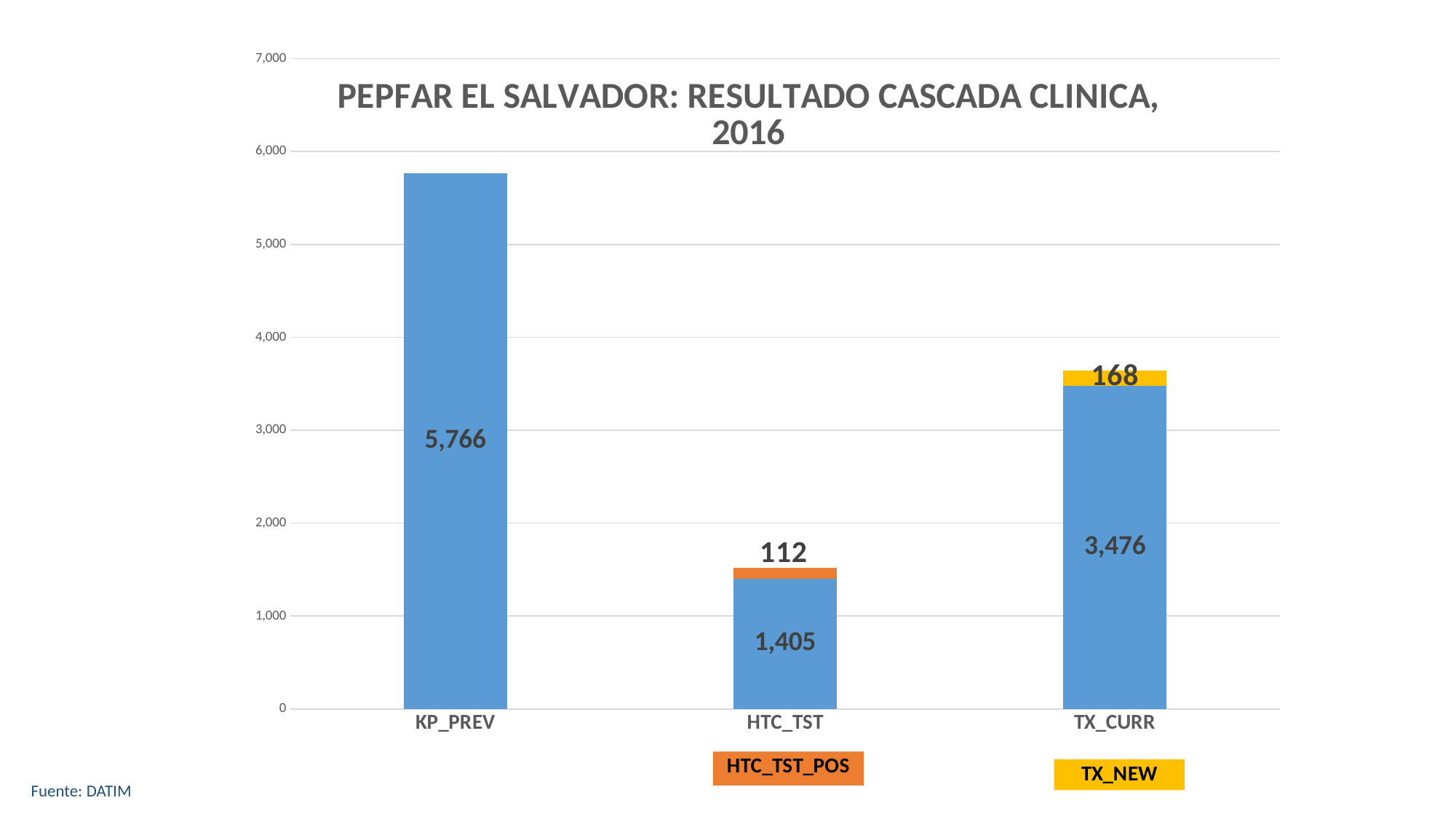
Which category has the shortest bar? HTC_TST What is the value of the blue HTC_TST segment? 1,405 What is the total of the stacked HTC_TST bar (HTC_TST plus HTC_TST_POS)? 1,517 What is the difference between the KP_PREV value and the blue TX_CURR value? 2,290 Which is larger, the blue TX_CURR value or the blue HTC_TST value? TX_CURR What type of chart is shown on the slide? Bar chart What is the value of the orange HTC_TST_POS segment? 112 How many categories are shown on the x axis? 3 What is the value of the blue TX_CURR segment? 3,476 What is the value of the KP_PREV bar? 5,766 Which category has the tallest bar? KP_PREV What is the value of the yellow TX_NEW segment? 168